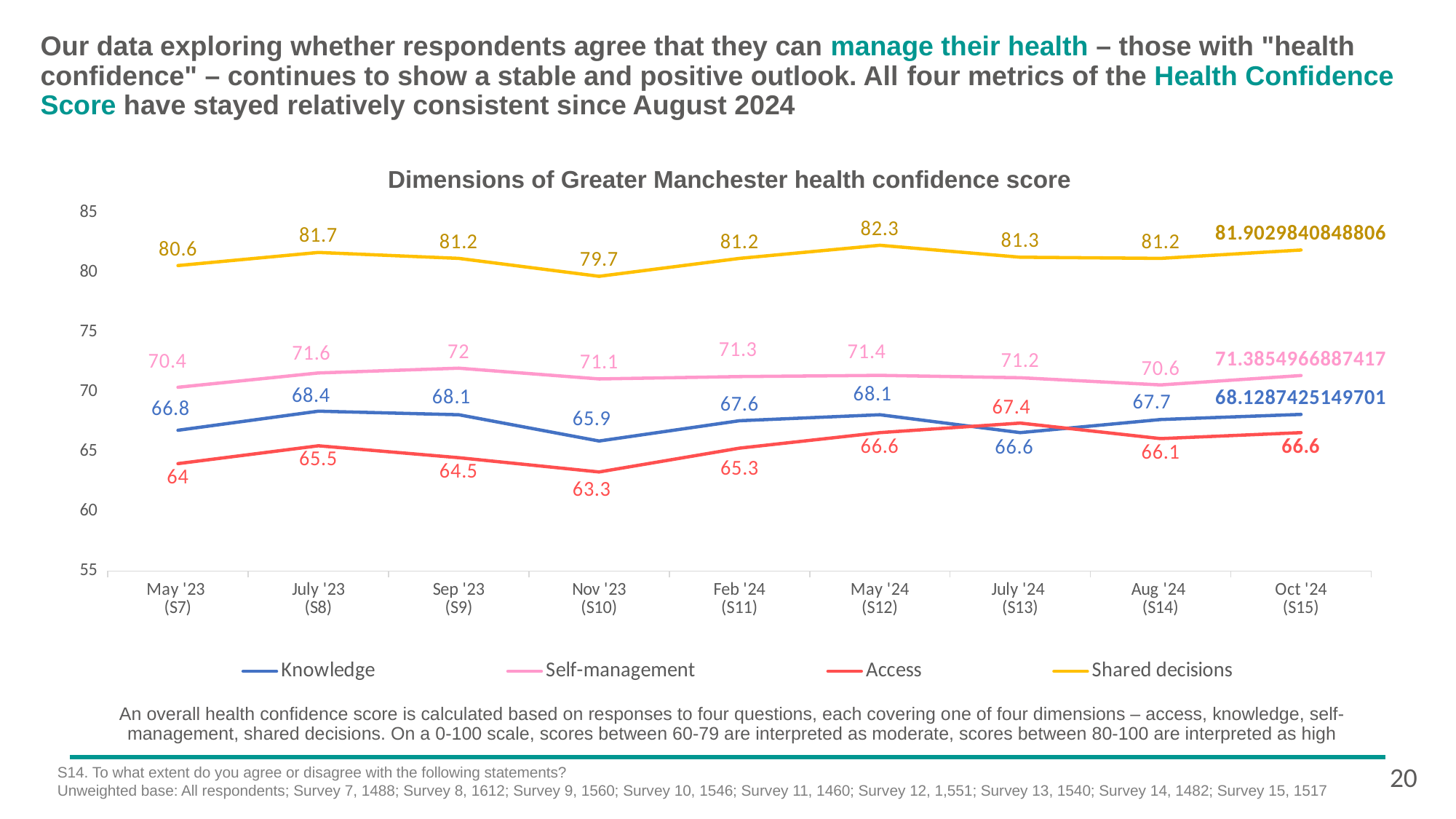
What is the difference between the Self-management values for Sep '23 (S9) and May '23 (S7)? 1.6 In which survey wave does the Shared decisions line reach its highest value? May '24 (S12) How many series does the legend list? 4 At July '24 (S13), which is higher: Knowledge or Access? Access How many survey waves are plotted along the x axis? 9 What is the Access value for Nov '23 (S10)? 63.3 Is the Shared decisions value for Nov '23 (S10) greater or less than 80? less What kind of chart is shown on the slide? line chart What is the Knowledge value for July '23 (S8)? 68.4 What is the Shared decisions value for May '24 (S12)? 82.3 In which survey wave is the Access value lowest? Nov '23 (S10) What colour is the Access line in the chart? red